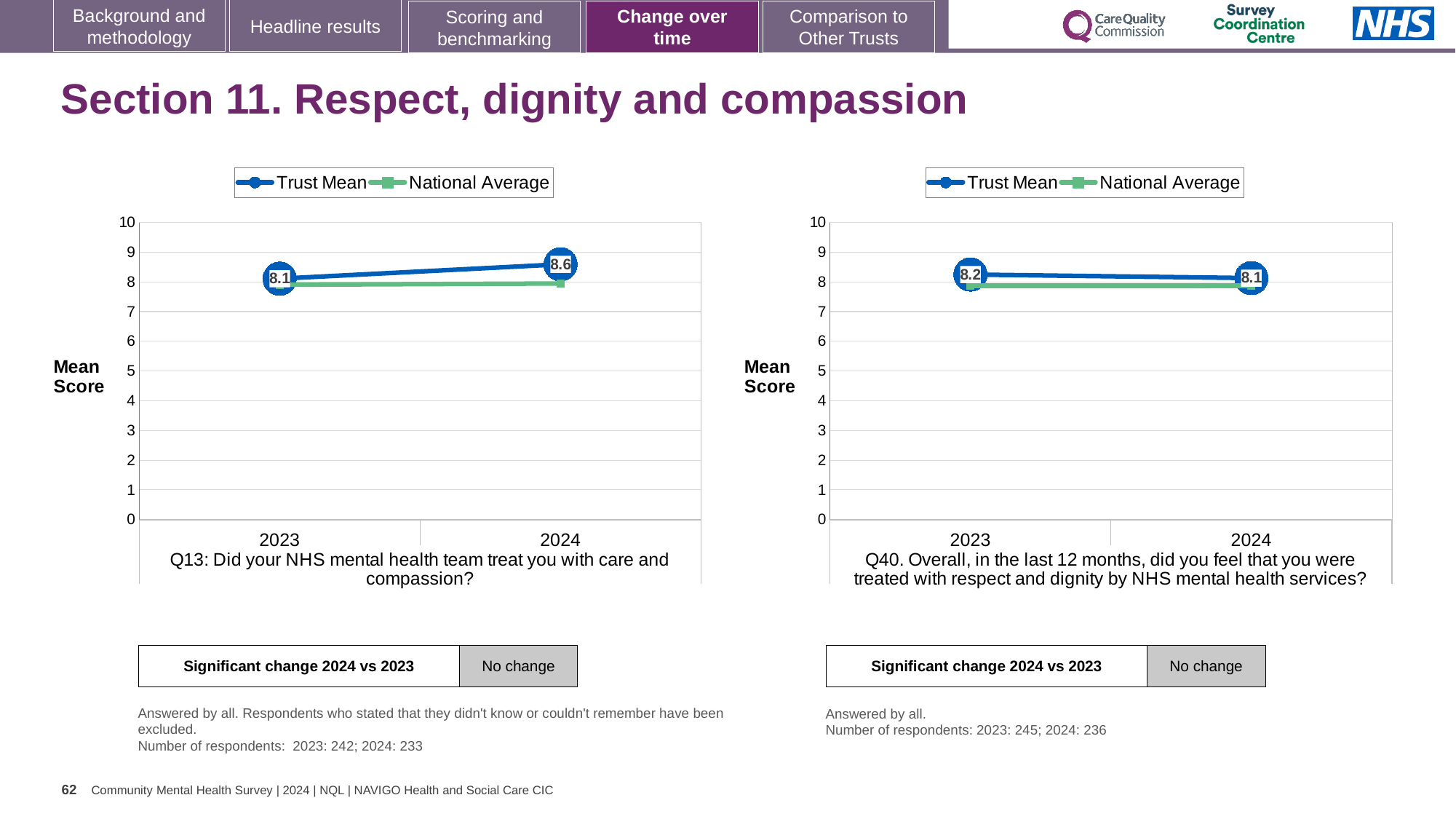
In the left chart (Q13), does the Trust Mean rise or fall from 2023 to 2024? rise In the right chart (Q40), is the National Average value for 2024 greater or less than 5? greater How many years are shown on the x axis of the left chart (Q13)? 2 In the left chart (Q13), is the Trust Mean or the National Average higher in 2024? Trust Mean In the left chart (Q13), by how much did the Trust Mean change from 2023 to 2024? 0.5 In the right chart (Q40), does the Trust Mean rise or fall from 2023 to 2024? fall In the right chart (Q40), what is the Trust Mean score for 2023? 8.2 What kind of chart is the left chart (Q13)? line chart In the left chart (Q13), what is the Trust Mean score for 2024? 8.6 In the right chart (Q40), what is the Trust Mean score for 2024? 8.1 How many series does the legend of the right chart (Q40) list? 2 In the left chart (Q13), what is the Trust Mean score for 2023? 8.1